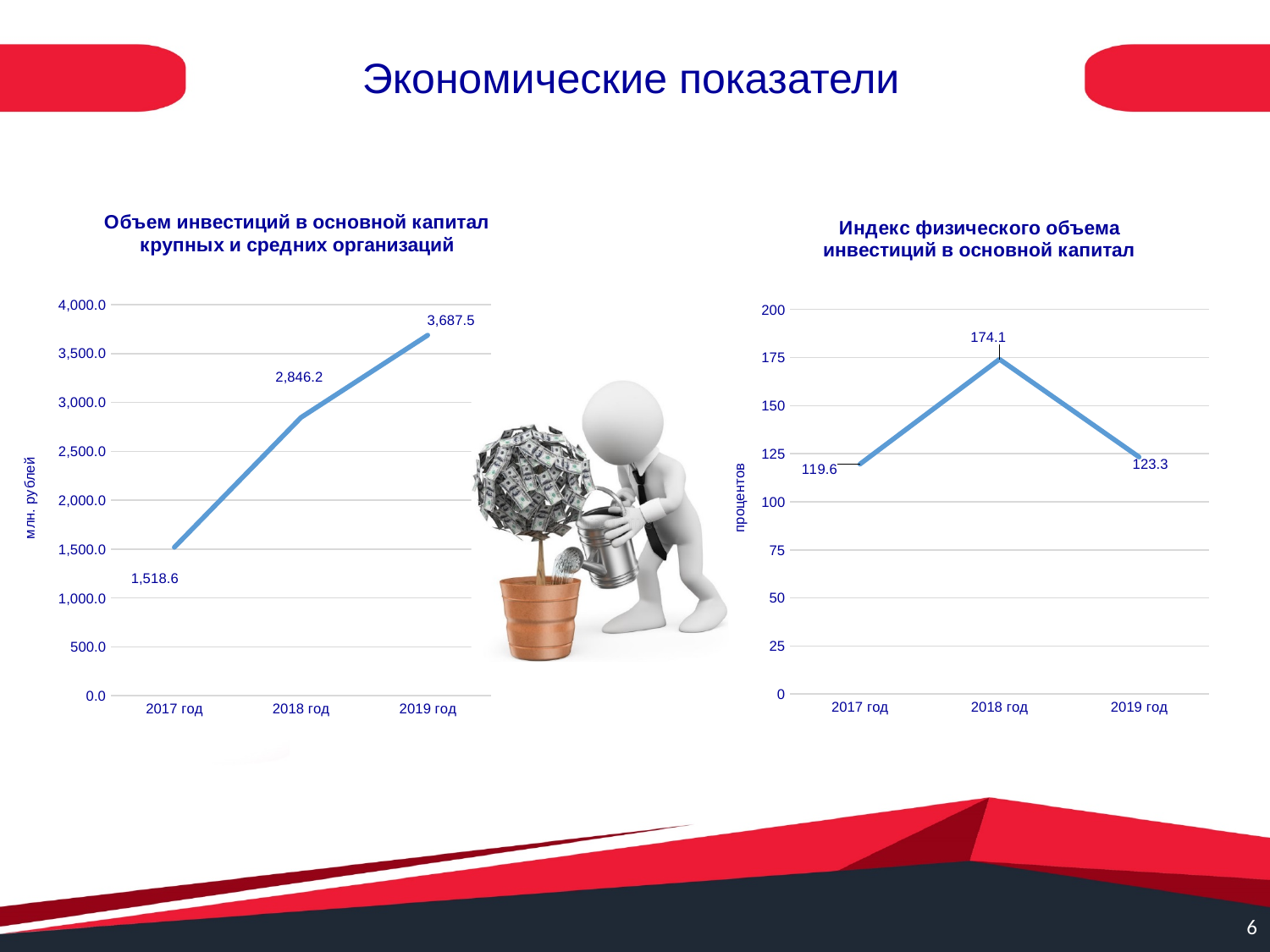
In the chart 'Индекс физического объема инвестиций в основной капитал', what is the value for 2018 год? 174.1 What is the y-axis label of the chart 'Объем инвестиций в основной капитал крупных и средних организаций'? млн. рублей In the chart 'Индекс физического объема инвестиций в основной капитал', how many data points are plotted? 3 In the chart 'Индекс физического объема инвестиций в основной капитал', what is the difference between the 2018 год and 2019 год values? 50.8 In the chart 'Объем инвестиций в основной капитал крупных и средних организаций', what is the value for 2019 год? 3,687.5 In the chart 'Объем инвестиций в основной капитал крупных и средних организаций', which year has the highest value? 2019 год In the chart 'Объем инвестиций в основной капитал крупных и средних организаций', do the values rise or fall from 2017 год to 2019 год? rise What type of chart is 'Объем инвестиций в основной капитал крупных и средних организаций'? line chart In the chart 'Объем инвестиций в основной капитал крупных и средних организаций', what is the value for 2017 год? 1,518.6 In the chart 'Объем инвестиций в основной капитал крупных и средних организаций', what is the difference between the 2019 год and 2018 год values? 841.3 In the chart 'Индекс физического объема инвестиций в основной капитал', which year has the lowest value? 2017 год In the chart 'Индекс физического объема инвестиций в основной капитал', what is the value for 2017 год? 119.6